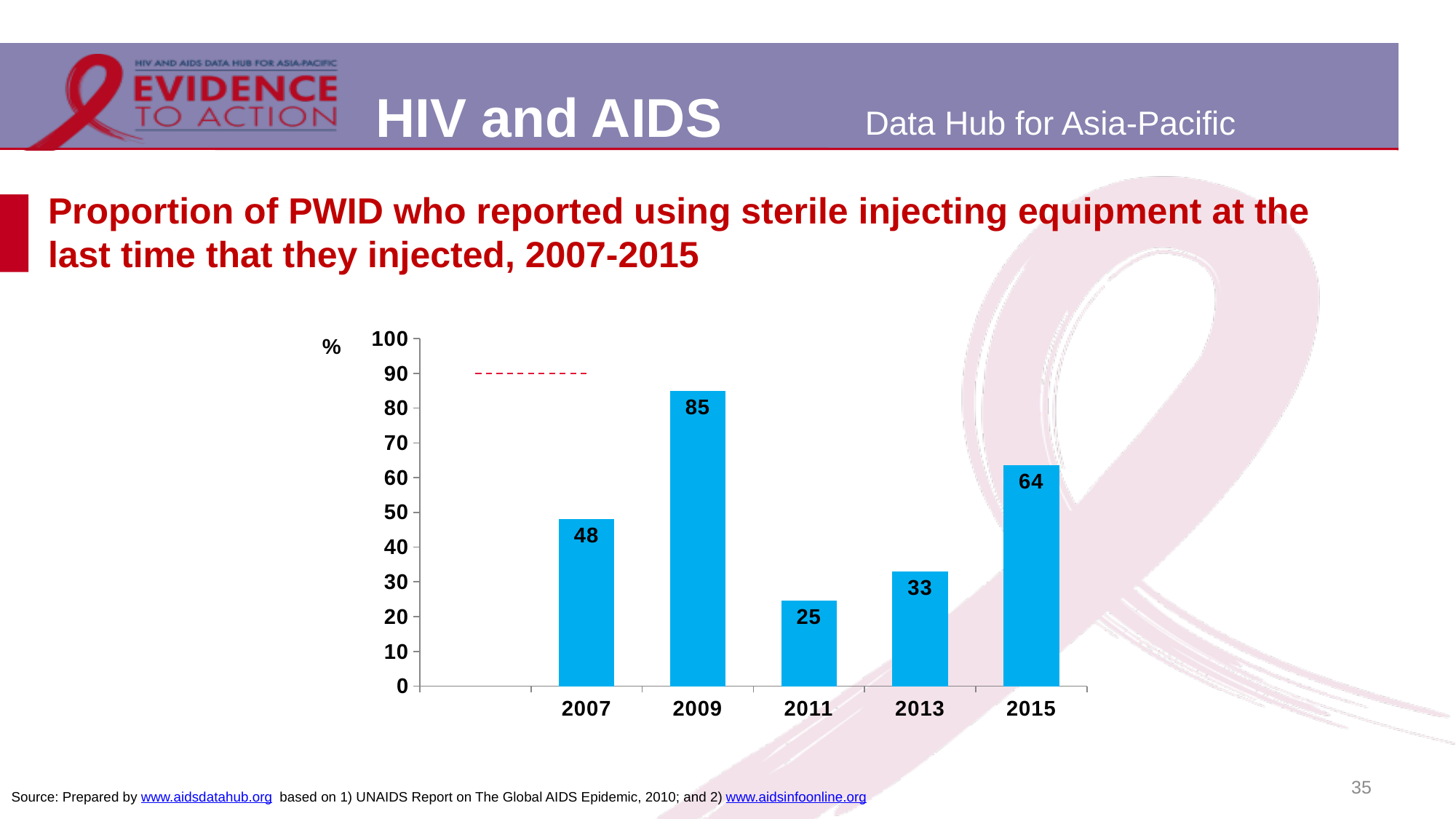
What is the difference between the values for 2009 and 2007? 37 What is the difference between the values for 2015 and 2013? 31 Which year has the highest value? 2009 What kind of chart is shown on the slide? bar chart What is the value for 2011? 25 Which year has the lowest value? 2011 What is the value for 2015? 64 What is the value for 2009? 85 Is the value for 2015 greater or less than 50? greater How many years are shown on the x axis? 5 What unit label is shown at the top of the y axis? % Which is larger, the value for 2007 or the value for 2013? 2007